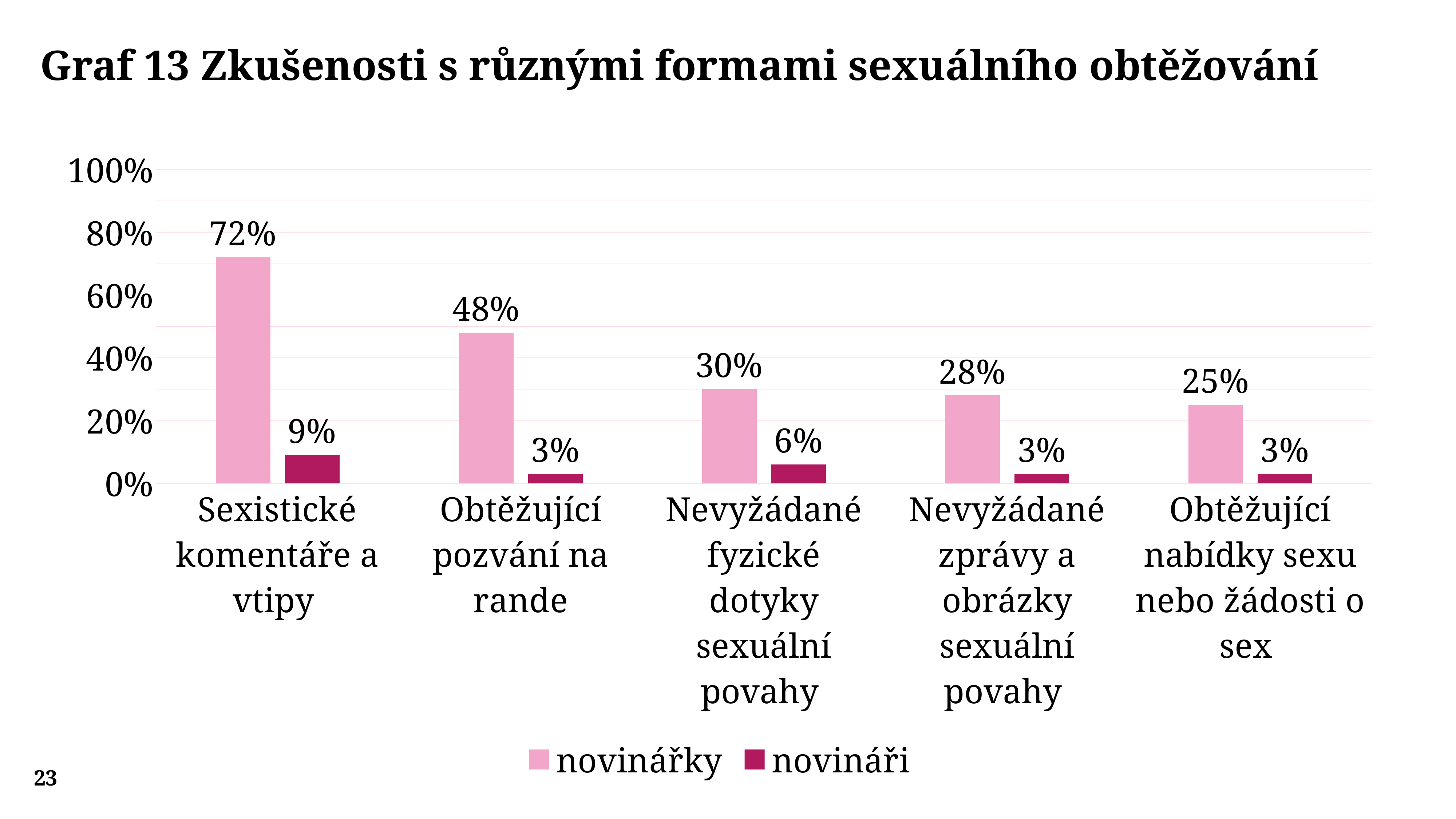
What is the value for novináři for 'Nevyžádané fyzické dotyky sexuální povahy'? 6% How many series does the legend list? 2 Which category has the lowest value for novinářky? Obtěžující nabídky sexu nebo žádosti o sex Which category has the highest value for novinářky? Sexistické komentáře a vtipy What kind of chart is shown on the slide? bar chart Which is larger: the novinářky value for 'Nevyžádané fyzické dotyky sexuální povahy' or the novinářky value for 'Nevyžádané zprávy a obrázky sexuální povahy'? Nevyžádané fyzické dotyky sexuální povahy What is the value for novinářky for 'Sexistické komentáře a vtipy'? 72% Is the novinářky value for 'Obtěžující pozvání na rande' greater or less than 40%? greater What is the value for novinářky for 'Obtěžující nabídky sexu nebo žádosti o sex'? 25% What is the difference between the novinářky and novináři values for 'Obtěžující pozvání na rande'? 45% Which category has the highest value for novináři? Sexistické komentáře a vtipy How many categories are shown on the x axis? 5